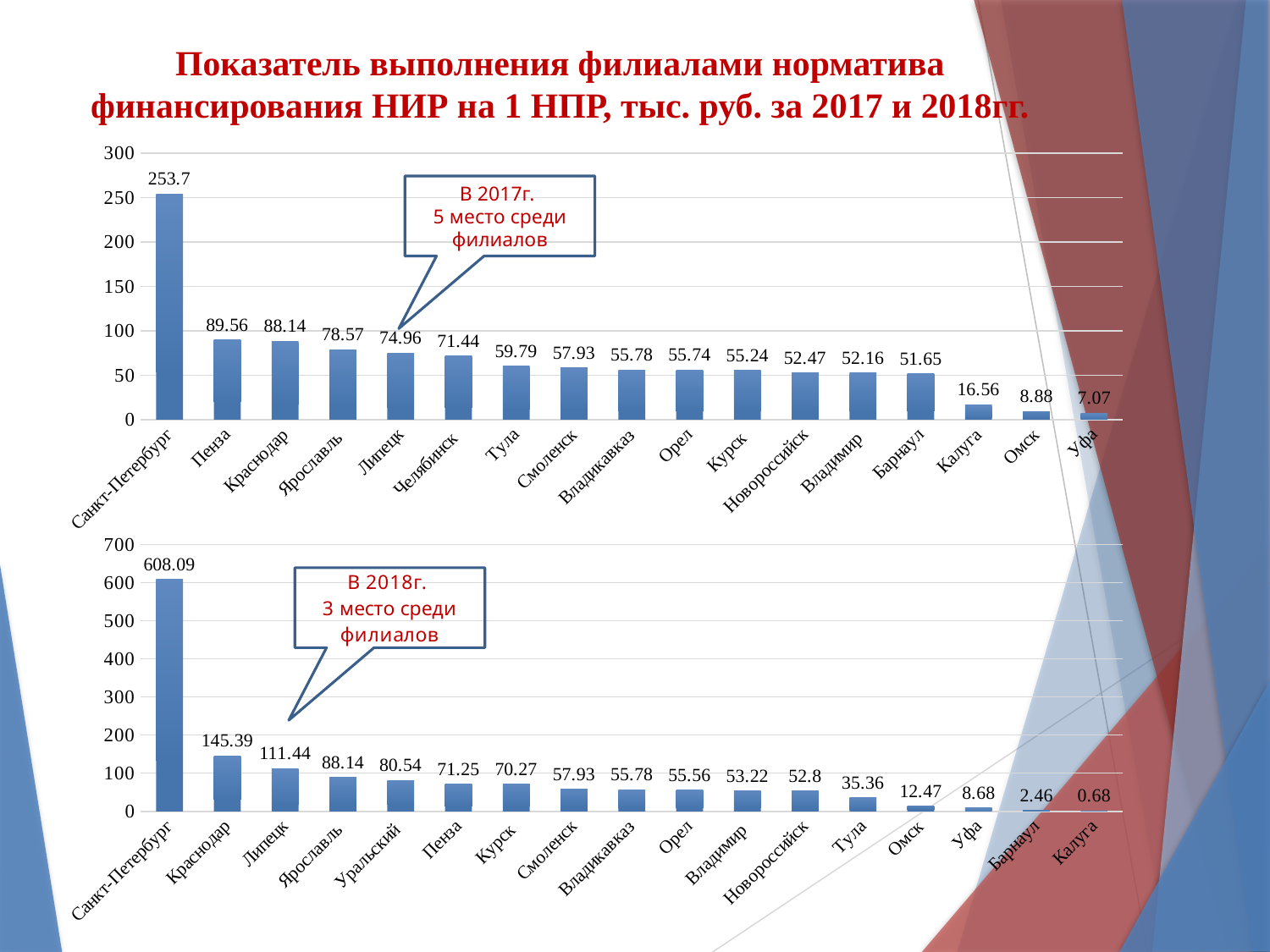
In the bottom chart (2018), is the value for Липецк greater or less than 100? greater How many branches are shown in the top chart (2017)? 17 In the top chart (2017), what is the value for Пенза? 89.56 In the top chart (2017), which branch has the highest value? Санкт-Петербург In the bottom chart (2018), what is the value for Краснодар? 145.39 According to the callout on the top chart, what place did Липецк hold among the branches in 2017? 5 место In the top chart (2017), which is larger: the value for Липецк or the value for Челябинск? Липецк What type of chart is the bottom chart (2018)? bar chart In the bottom chart (2018), do the values rise or fall from left to right along the x axis? fall In the bottom chart (2018), which branch has the lowest value? Калуга In the top chart (2017), which branch has the lowest value? Уфа In the bottom chart (2018), what is the difference between the values for Санкт-Петербург and Краснодар? 462.7